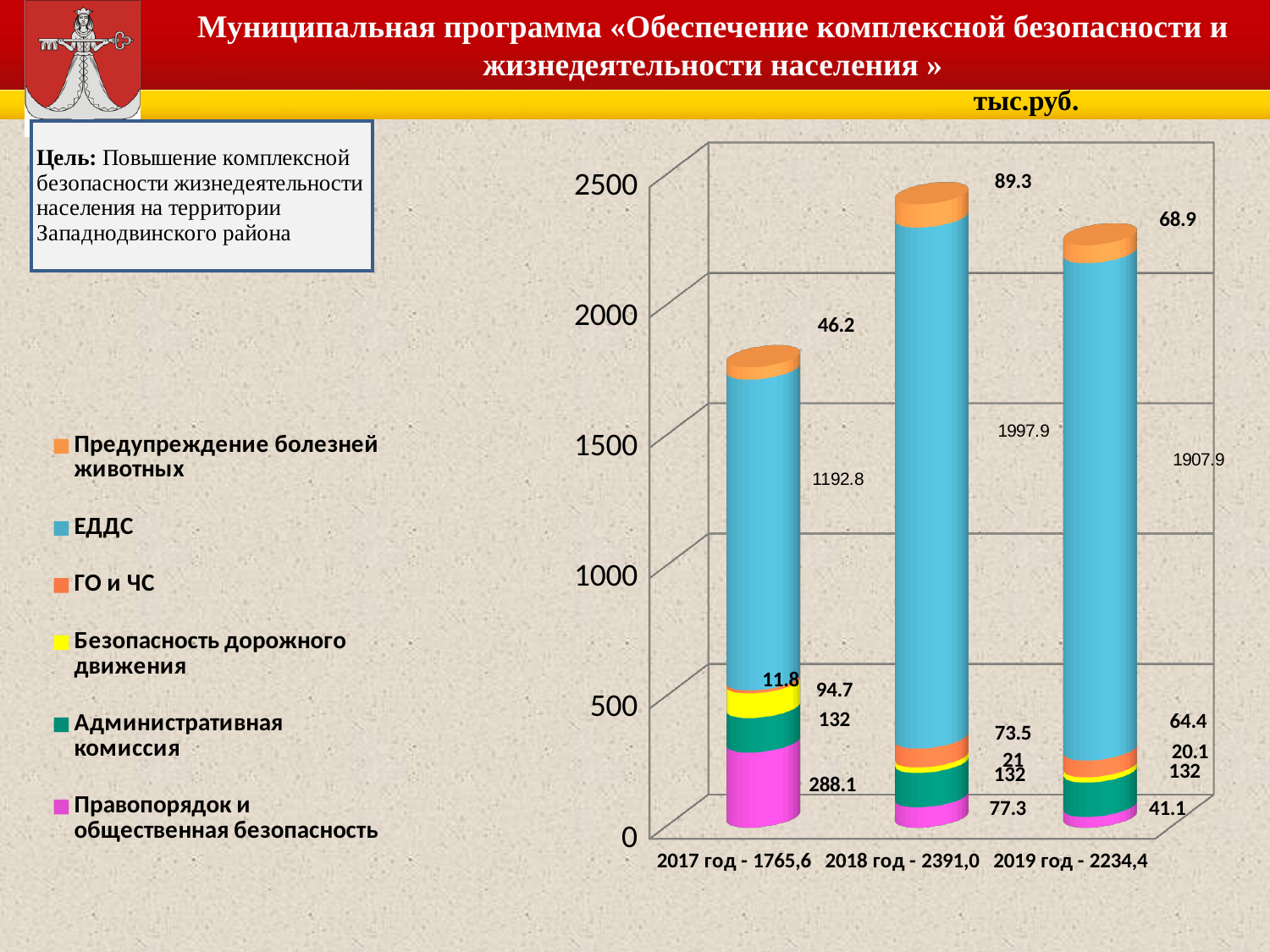
In which year is the ЕДДС value highest? 2018 What kind of chart is shown on the slide? stacked bar chart In which year is the Правопорядок и общественная безопасность value lowest? 2019 Which is larger: ГО и ЧС in 2018 or ГО и ЧС in 2019? 2018 How many series does the legend list? 6 How many years (bars) are shown on the chart? 3 What is the total of the stacked bar for 2018 год? 2391,0 What is the value for ЕДДС in 2018? 1997.9 What is the value for Правопорядок и общественная безопасность in 2017? 288.1 What is the value for Предупреждение болезней животных in 2019? 68.9 What is the difference between the ЕДДС values for 2018 and 2019? 90 Is the total height of the 2017 bar greater or less than 2000? less